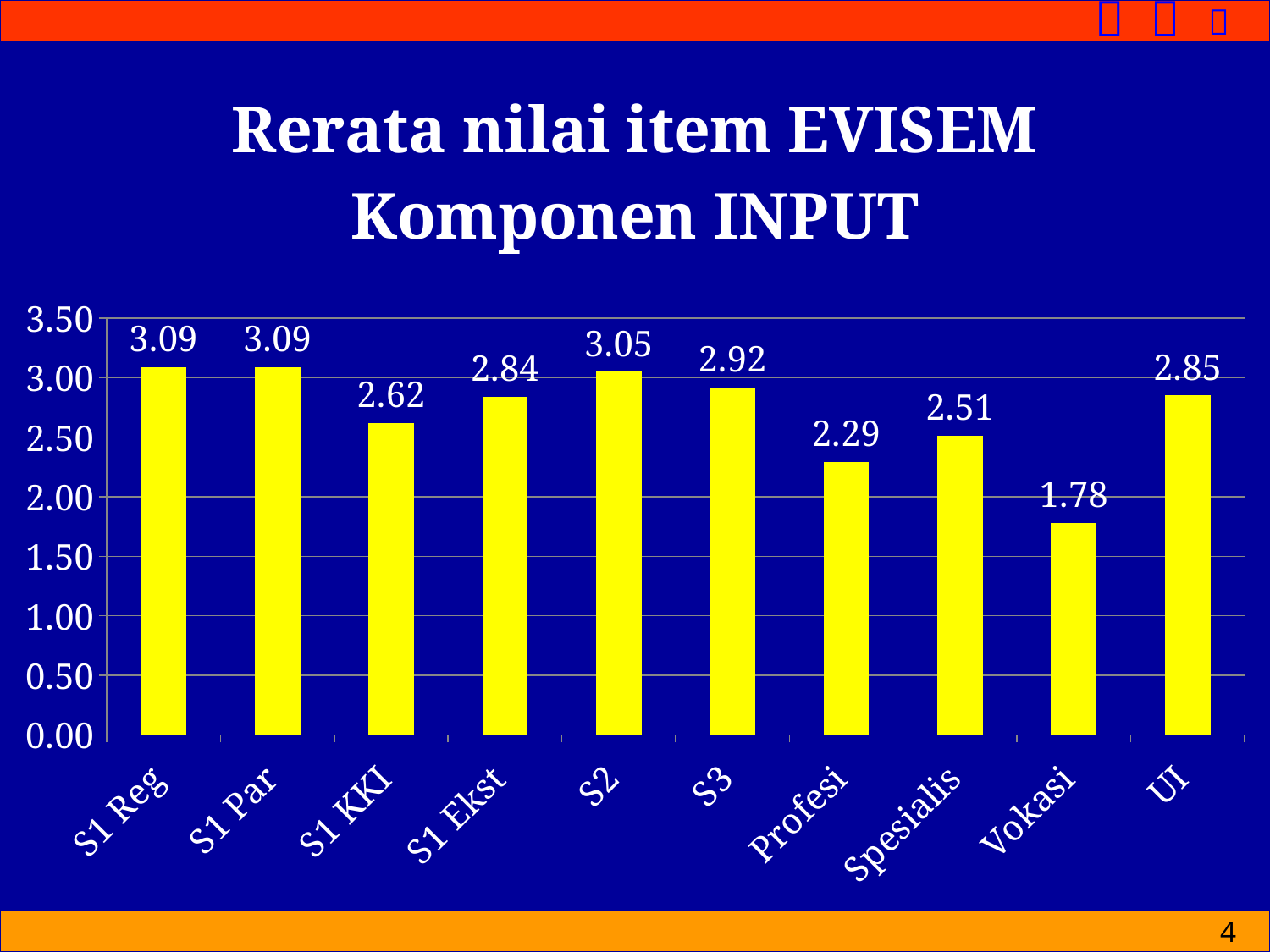
What is the value for Vokasi? 1.78 Which category has the lowest value? Vokasi How many categories are shown on the x axis? 10 What is the difference between the values for S2 and Spesialis? 0.54 What is the value for S1 KKI? 2.62 What is the value for Profesi? 2.29 Which is larger, the value for S1 Ekst or the value for S1 KKI? S1 Ekst What is the difference between the values for S3 and Vokasi? 1.14 What is the title of the slide containing the chart? Rerata nilai item EVISEM Komponen INPUT What is the value for UI? 2.85 What kind of chart is shown on the slide? bar chart Is the value for Spesialis greater or less than 3.00? less